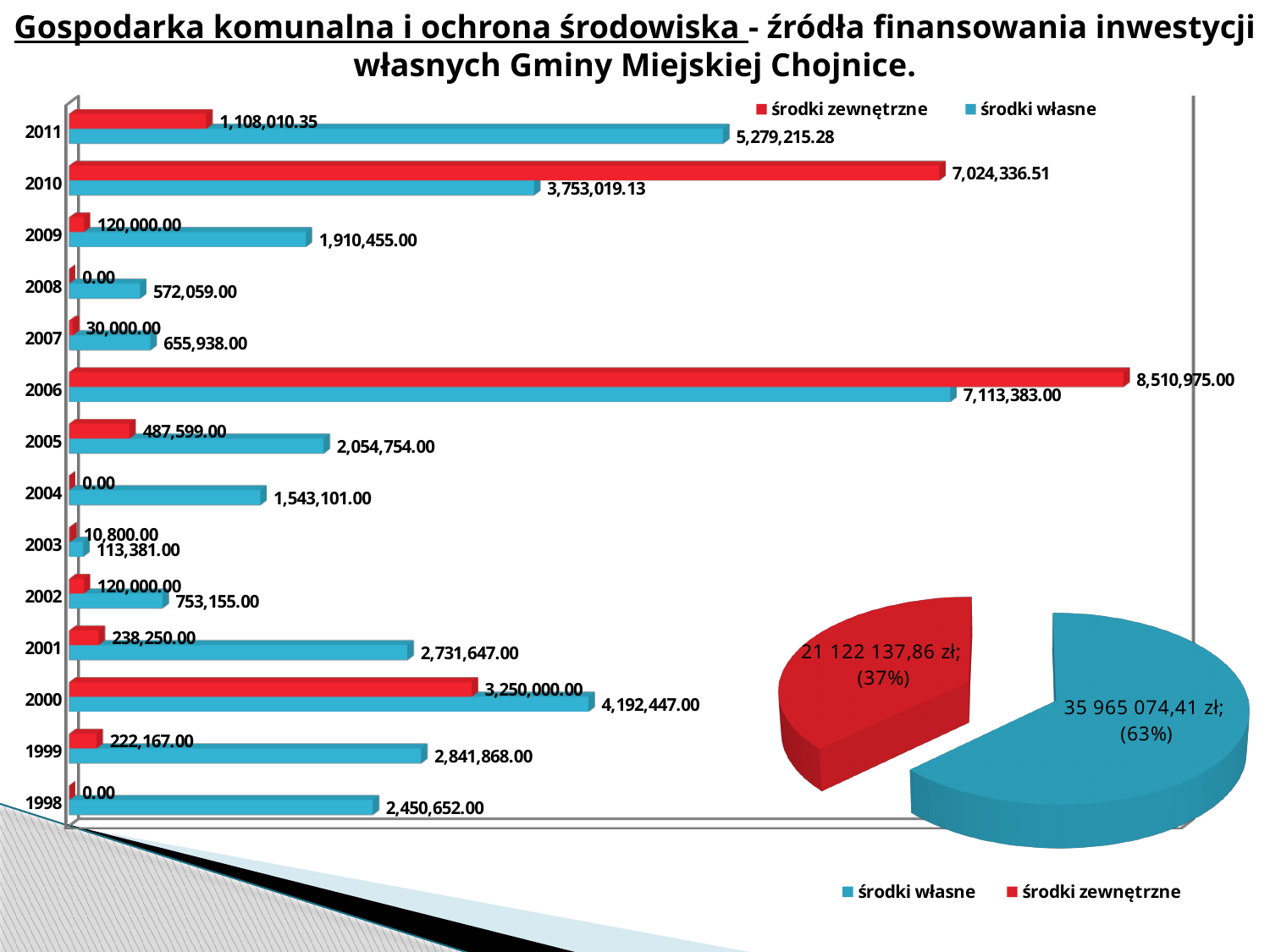
In the pie chart, what share does środki własne have? 63% In the bar chart, which year has the highest value of środki własne? 2006 In the bar chart, which is larger in 2000: środki zewnętrzne or środki własne? środki własne In the bar chart, what is the difference between środki zewnętrzne and środki własne in 2006? 1,397,592.00 In the bar chart, what is the value of środki zewnętrzne for 2005? 487,599.00 In the pie chart, what is the value shown for środki zewnętrzne? 21 122 137,86 zł In the bar chart, which year has the lowest value of środki własne? 2003 How many years are shown in the bar chart? 14 In the bar chart, what is the value of środki własne for 2011? 5,279,215.28 In the bar chart, what is the value of środki zewnętrzne for 2010? 7,024,336.51 What kind of chart is the chart on the left side of the slide? bar chart How many series does the legend of the bar chart list? 2